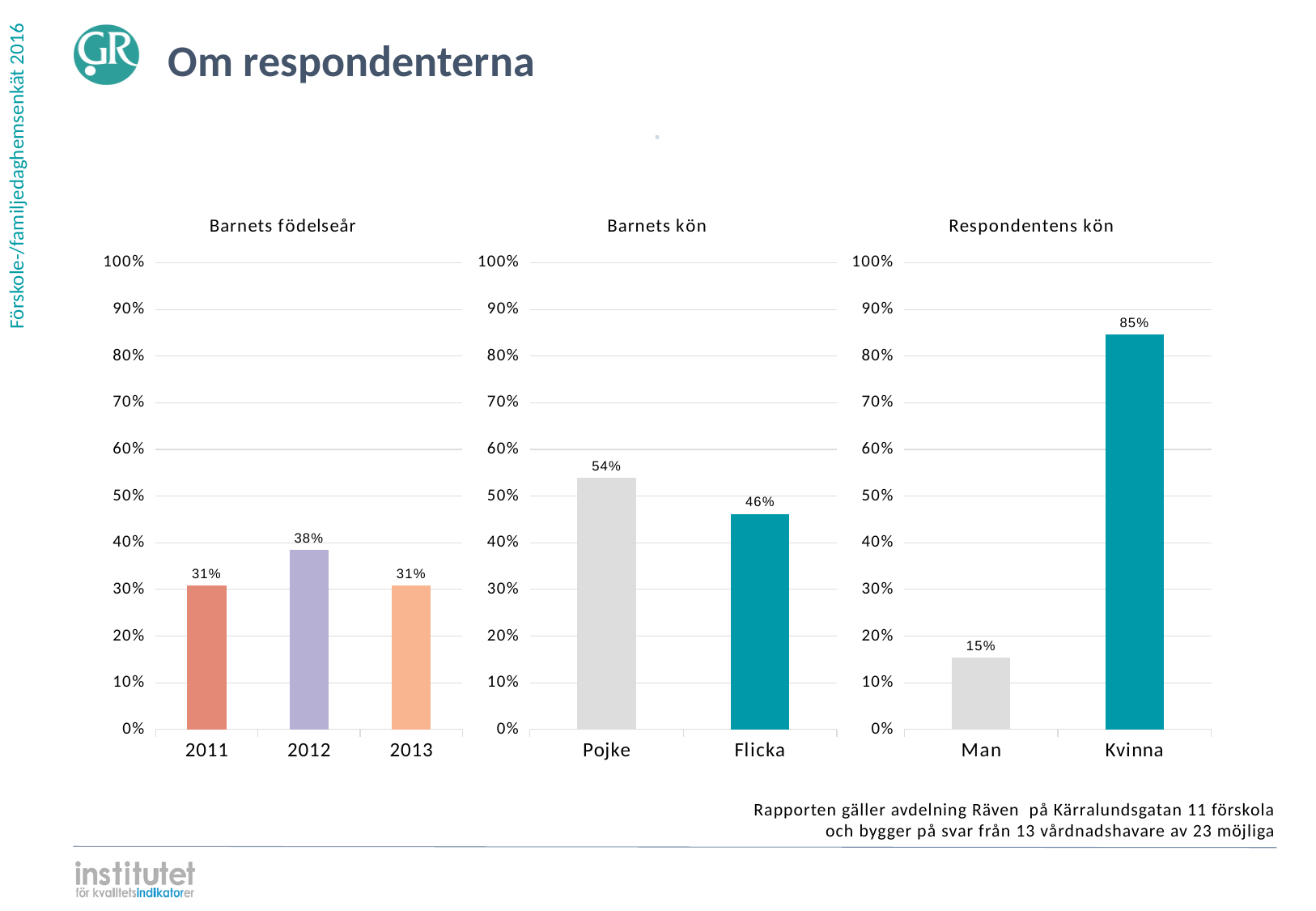
In the 'Barnets födelseår' chart, how many categories are shown on the x axis? 3 In the 'Barnets kön' chart, what is the value for Pojke? 54% In the 'Barnets födelseår' chart, what is the value for 2012? 38% What kind of chart is the 'Respondentens kön' chart? Bar chart In the 'Respondentens kön' chart, what is the difference between Kvinna and Man? 70% In the 'Respondentens kön' chart, what is the value for Kvinna? 85% In the 'Barnets födelseår' chart, what is the difference between the values for 2012 and 2011? 7% How many charts are shown on the slide? 3 In the 'Barnets födelseår' chart, which category has the highest value? 2012 In the 'Barnets kön' chart, what is the difference between Pojke and Flicka? 8% In the 'Respondentens kön' chart, which category has the lowest value? Man In the 'Barnets kön' chart, which is larger, Pojke or Flicka? Pojke